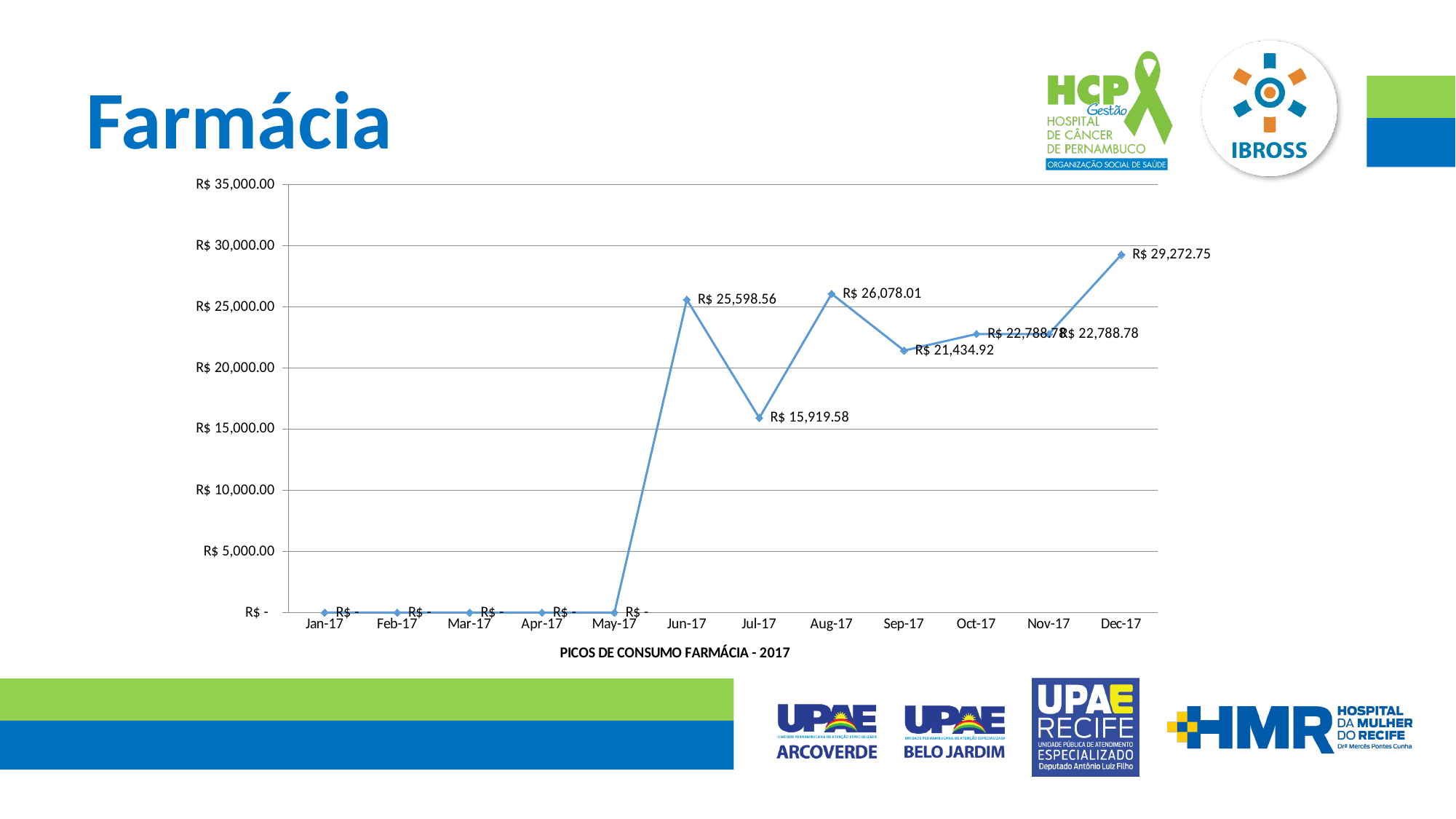
Which is larger, the value for Jun-17 or the value for Aug-17? Aug-17 How many months are plotted on the x axis? 12 What is the value for Dec-17? R$ 29,272.75 Which month has the highest value? Dec-17 What is the value for Jul-17? R$ 15,919.58 What is the difference between the values for Dec-17 and Aug-17? R$ 3,194.74 Among the months with a non-zero value, which month has the lowest value? Jul-17 What is the title shown below the chart? PICOS DE CONSUMO FARMÁCIA - 2017 What kind of chart is shown on the slide? line chart What is the value for Sep-17? R$ 21,434.92 Is the value for Jul-17 greater or less than R$ 20,000.00? less What is the value for Jun-17? R$ 25,598.56